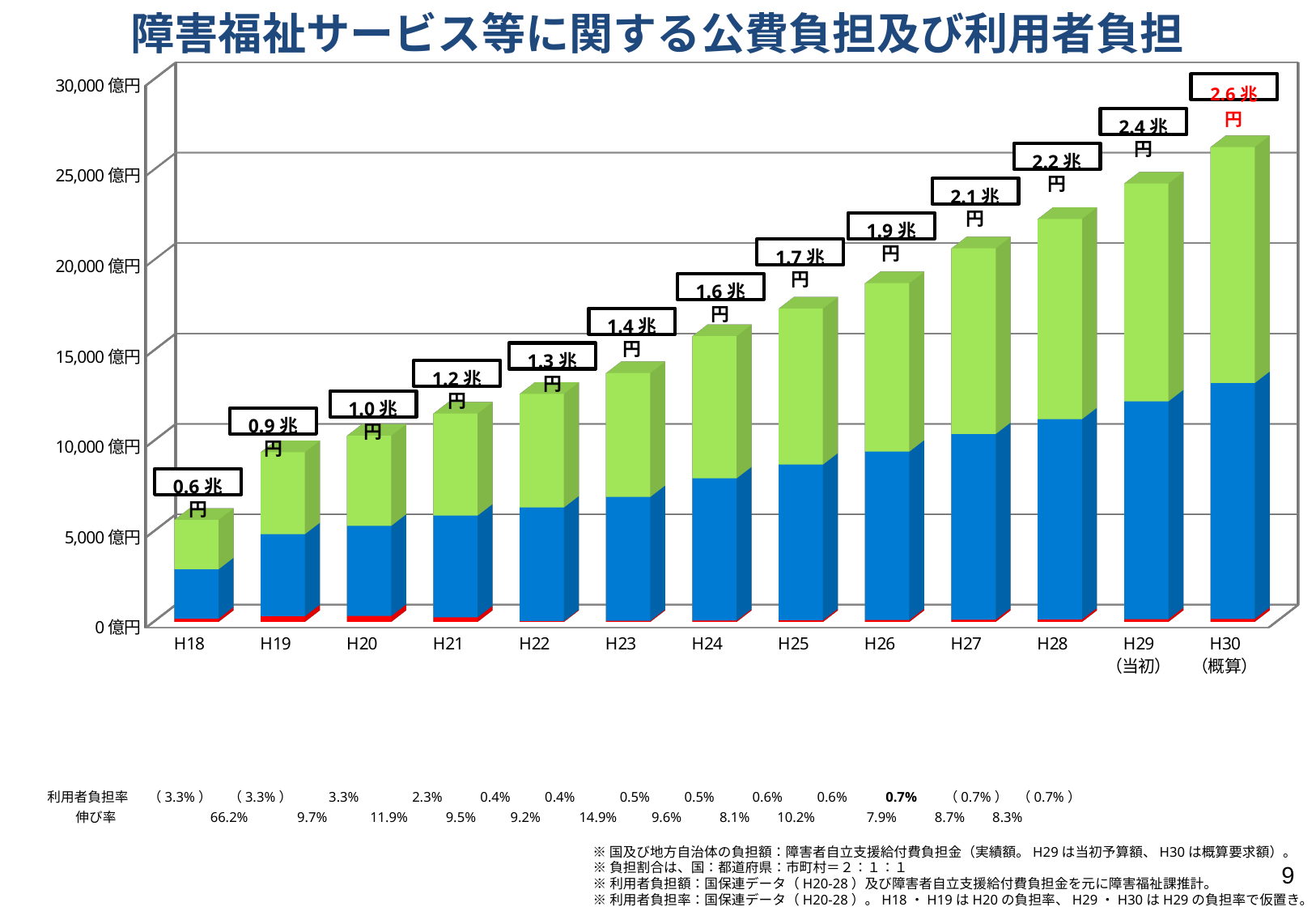
What is the difference between the labelled totals for H30（概算） and H18? 2.0兆円 How many years (categories) are shown on the x axis? 13 Which year has the highest total bar? H30（概算） Is the total bar for H22 greater or less than 15,000億円? less Which has a larger labelled total, H26 or H23? H26 What kind of chart is shown on the slide? Stacked bar chart What is the total labelled above the bar for H24? 1.6兆円 Do the total bar values rise or fall from H18 to H30? Rise Which year has the lowest total bar? H18 What is the total labelled above the bar for H18? 0.6兆円 What is the total labelled above the bar for H30（概算）? 2.6兆円 Is the total bar for H28 greater or less than 20,000億円? greater